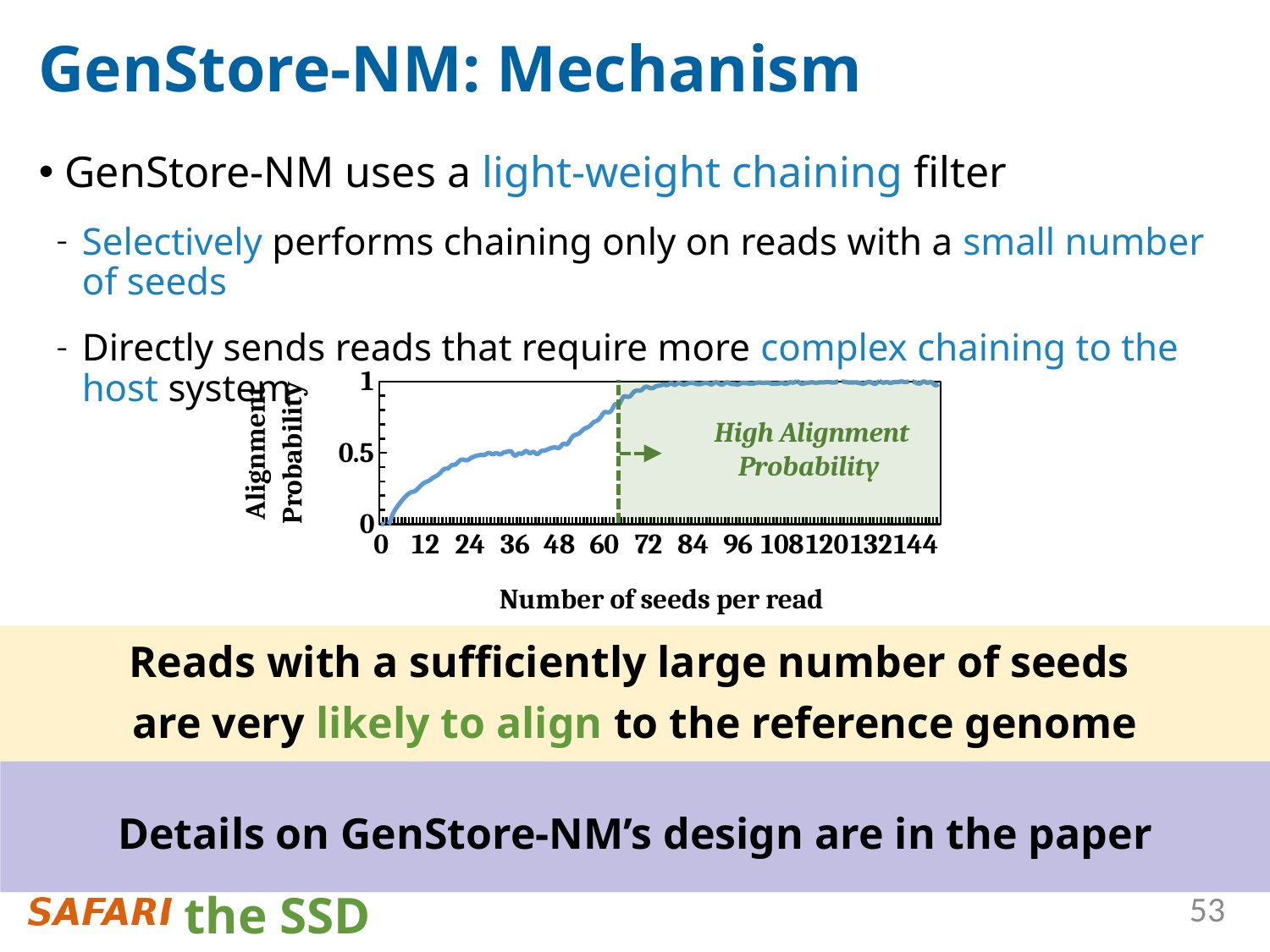
Is the alignment probability at 12 seeds per read greater or less than 0.5? less What label is written inside the shaded region of the chart? High Alignment Probability Is the alignment probability at 96 seeds per read greater or less than 0.5? greater What is the label of the x axis of the chart? Number of seeds per read Is the alignment probability at 120 seeds per read greater or less than 0.5? greater What kind of chart is shown on the slide? line chart Does the alignment probability rise or fall as the number of seeds per read increases? rise